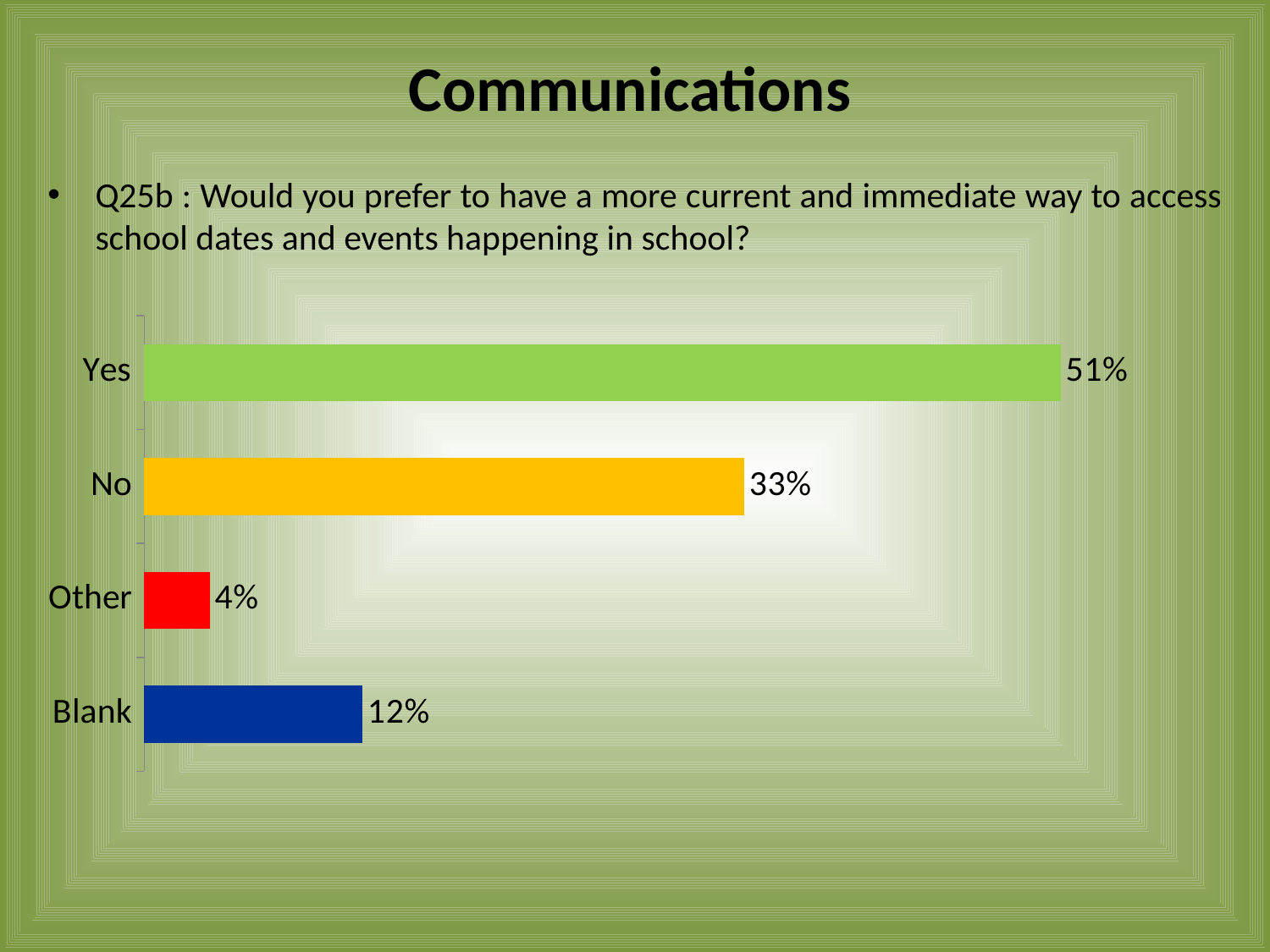
How many categories are shown in the chart? 4 What is the value for Yes? 51% What is the difference between the values for Blank and Other? 8% What is the value for No? 33% What kind of chart is shown on the slide? Bar chart What is the difference between the values for Yes and No? 18% What is the value for Other? 4% Which is larger, the value for No or the value for Blank? No Which category has the highest value? Yes Which category has the lowest value? Other What is the value for Blank? 12% What colour is the bar for Other? Red